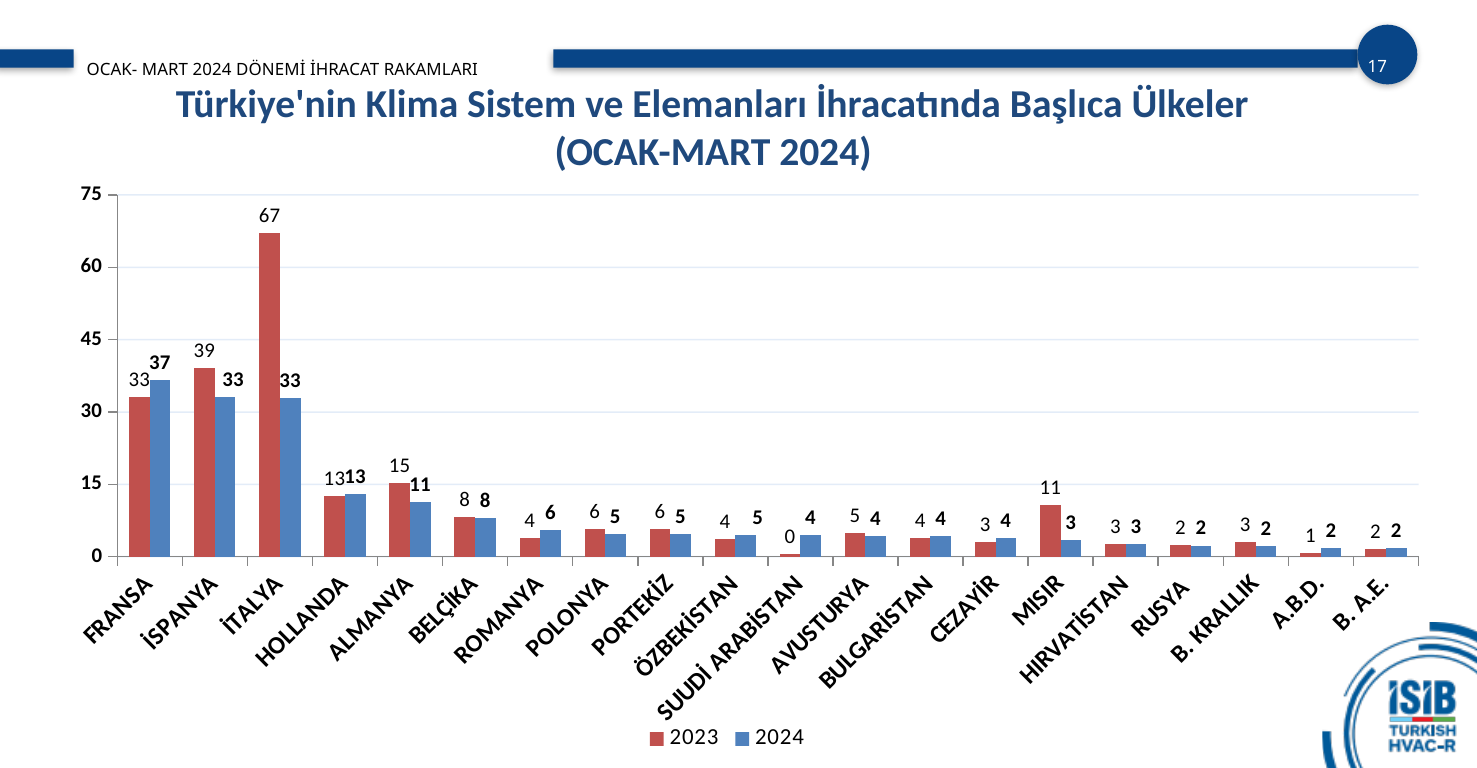
Is the 2023 value for İTALYA greater or less than 60? greater What is the difference between the 2023 and 2024 values for İTALYA? 34 What kind of chart is shown on the slide? bar chart What is the 2023 value for MISIR? 11 What is the 2023 value for İTALYA? 67 How many countries are shown on the x axis? 20 What is the 2024 value for FRANSA? 37 Which country has the highest 2023 value? İTALYA Which is larger for İSPANYA, the 2023 value or the 2024 value? 2023 How many series does the legend list? 2 Which country has the highest 2024 value? FRANSA Which country has the lowest 2023 value? SUUDİ ARABİSTAN